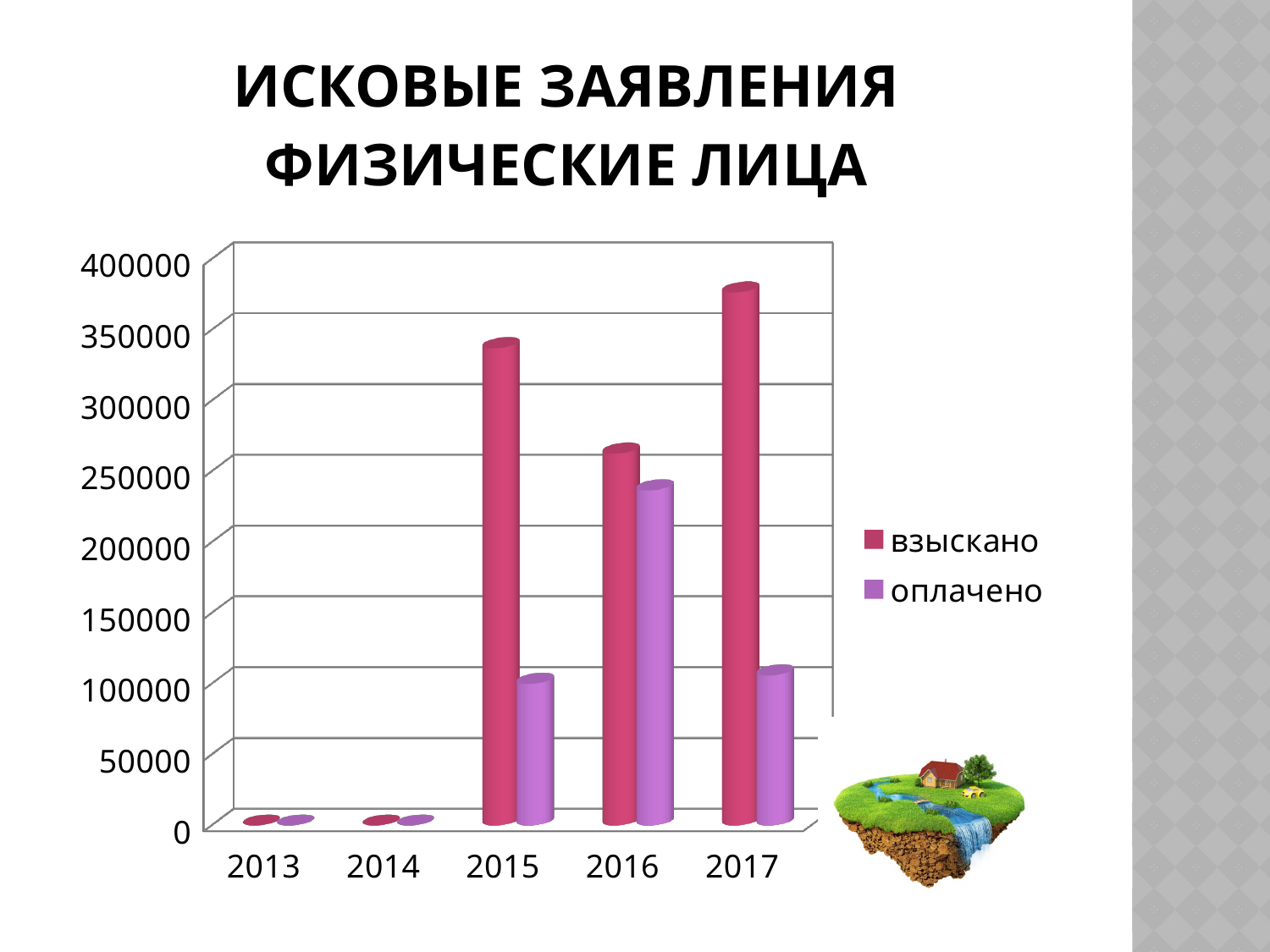
In which year is the value for взыскано the highest? 2017 Is the value for взыскано in 2017 greater or less than 350000? greater How many series does the chart legend list? 2 Is the value for взыскано in 2015 greater or less than 300000? greater What kind of chart is shown on the slide? bar chart Is the value for оплачено in 2016 greater or less than 200000? greater How many years are shown on the x axis of the chart? 5 In which year is the value for оплачено the highest? 2016 What are the two series named in the chart legend? взыскано and оплачено Which year has the larger value for взыскано: 2015 or 2017? 2017 Which is larger in 2016: взыскано or оплачено? взыскано